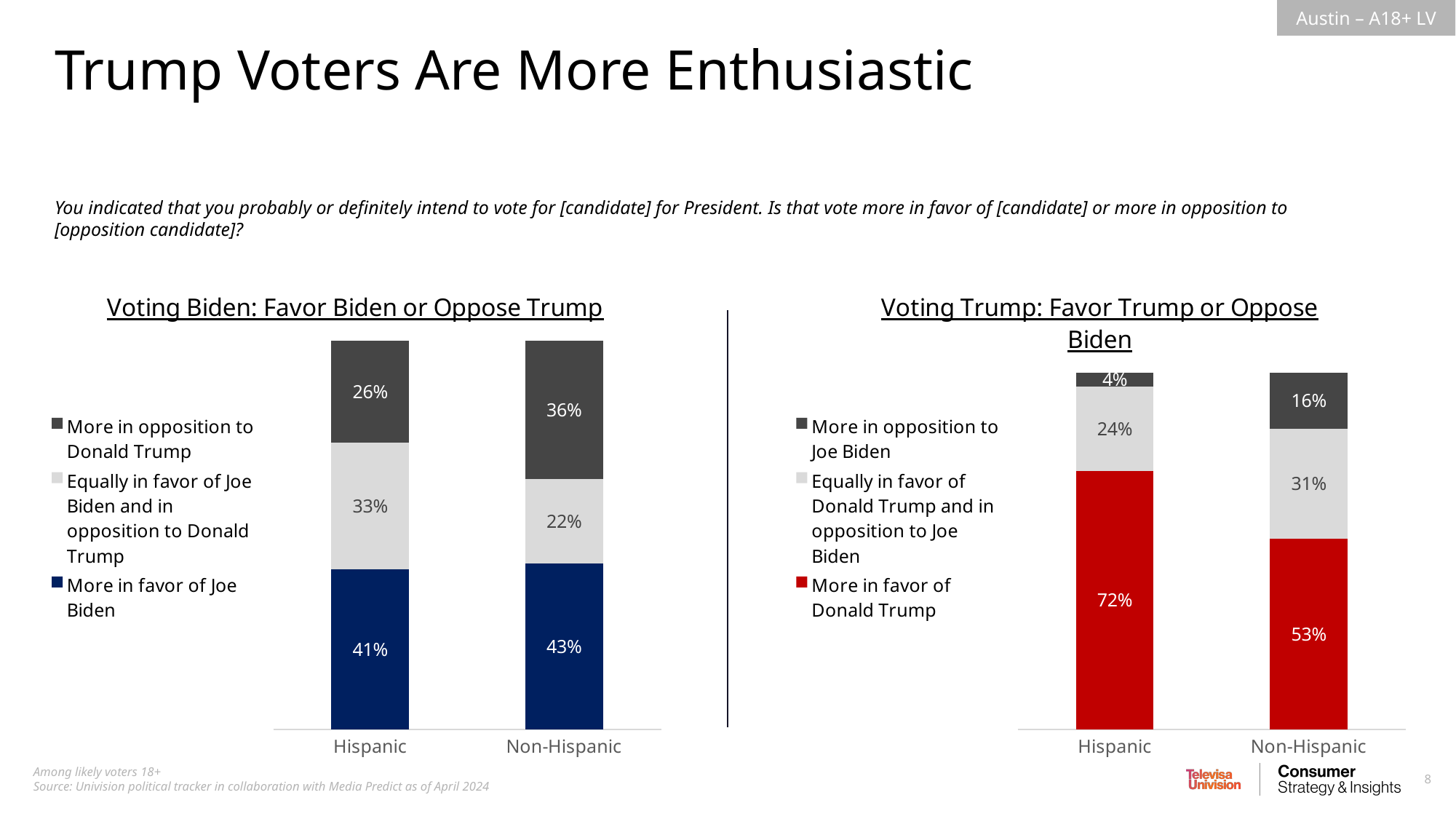
In the 'Voting Trump: Favor Trump or Oppose Biden' chart, what percentage of Hispanic voters are 'More in favor of Donald Trump'? 72% What kind of chart is the 'Voting Trump: Favor Trump or Oppose Biden' chart? Stacked bar chart In the 'Voting Biden: Favor Biden or Oppose Trump' chart, what percentage of Hispanic voters are 'More in favor of Joe Biden'? 41% In the 'Voting Trump: Favor Trump or Oppose Biden' chart, what colour represents 'More in favor of Donald Trump'? Red How many categories are shown on the x axis of the 'Voting Biden: Favor Biden or Oppose Trump' chart? 2 In the 'Voting Trump: Favor Trump or Oppose Biden' chart, which group has the smaller value for 'More in opposition to Joe Biden'? Hispanic In the 'Voting Trump: Favor Trump or Oppose Biden' chart, what percentage of Non-Hispanic voters are 'Equally in favor of Donald Trump and in opposition to Joe Biden'? 31% In the 'Voting Biden: Favor Biden or Oppose Trump' chart, which group has the larger value for 'Equally in favor of Joe Biden and in opposition to Donald Trump', Hispanic or Non-Hispanic? Hispanic In the 'Voting Biden: Favor Biden or Oppose Trump' chart, what is the total of the Hispanic stacked bar? 100% In the 'Voting Trump: Favor Trump or Oppose Biden' chart, what is the difference between the Hispanic and Non-Hispanic values for 'More in favor of Donald Trump'? 19% How many series does the legend of the 'Voting Trump: Favor Trump or Oppose Biden' chart list? 3 In the 'Voting Biden: Favor Biden or Oppose Trump' chart, what percentage of Non-Hispanic voters are 'More in opposition to Donald Trump'? 36%